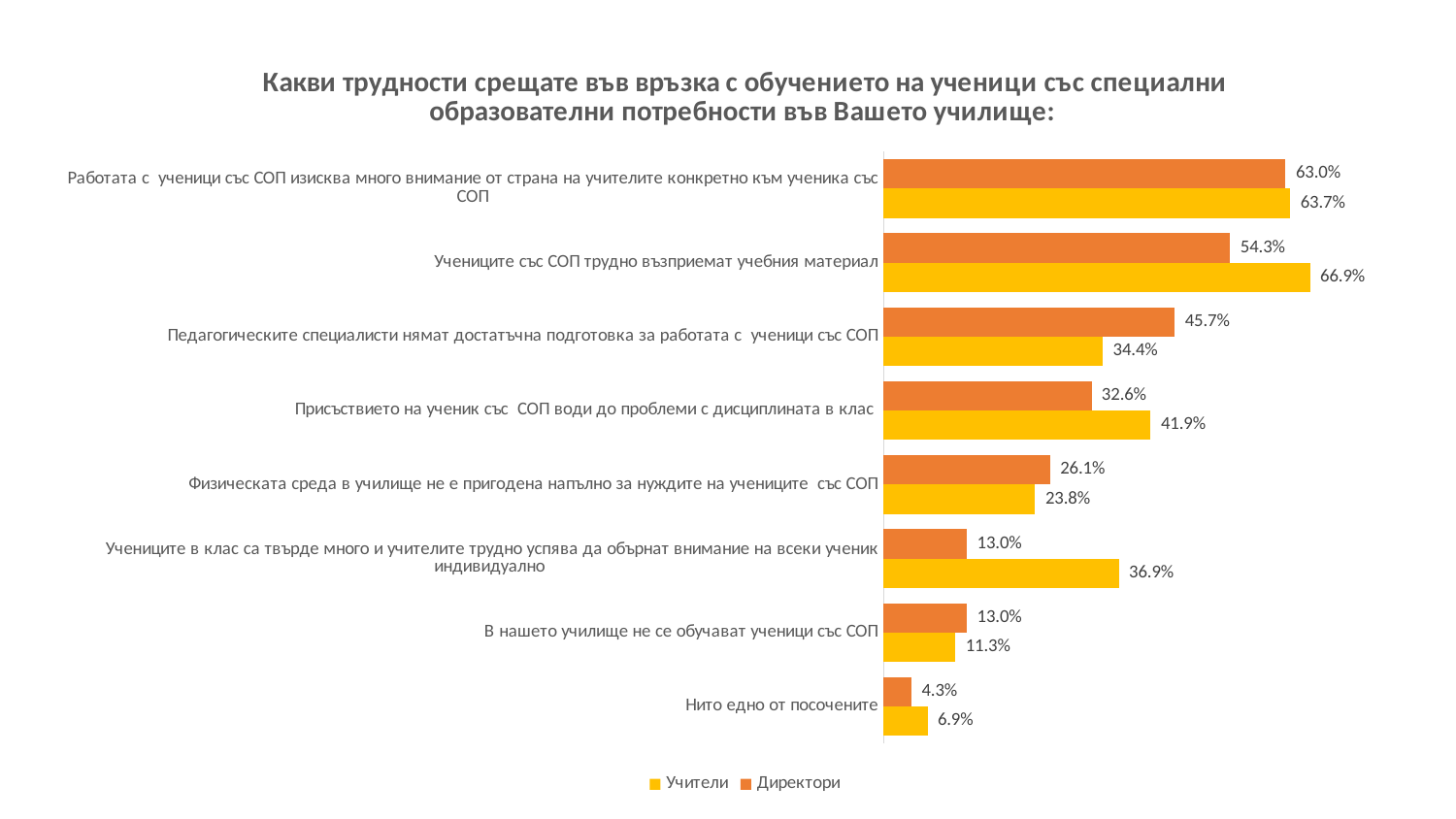
What is the value for Учители for "Учениците в клас са твърде много и учителите трудно успява да обърнат внимание на всеки ученик индивидуално"? 36.9% What is the value for Директори for "Педагогическите специалисти нямат достатъчна подготовка за работата с ученици със СОП"? 45.7% Which category has the lowest value for Директори? Нито едно от посочените How many series does the legend list? 2 Which category has the highest value for Учители? Учениците със СОП трудно възприемат учебния материал How many categories are shown on the chart? 8 Which colour represents the Директори series? Orange What kind of chart is shown on the slide? Bar chart For "Присъствието на ученик със СОП води до проблеми с дисциплината в клас", which series has the larger value, Учители or Директори? Учители What is the value for Учители for "Учениците със СОП трудно възприемат учебния материал"? 66.9% What is the value for Директори for "Нито едно от посочените"? 4.3% What is the difference between the Учители and Директори values for "Учениците в клас са твърде много и учителите трудно успява да обърнат внимание на всеки ученик индивидуално"? 23.9%